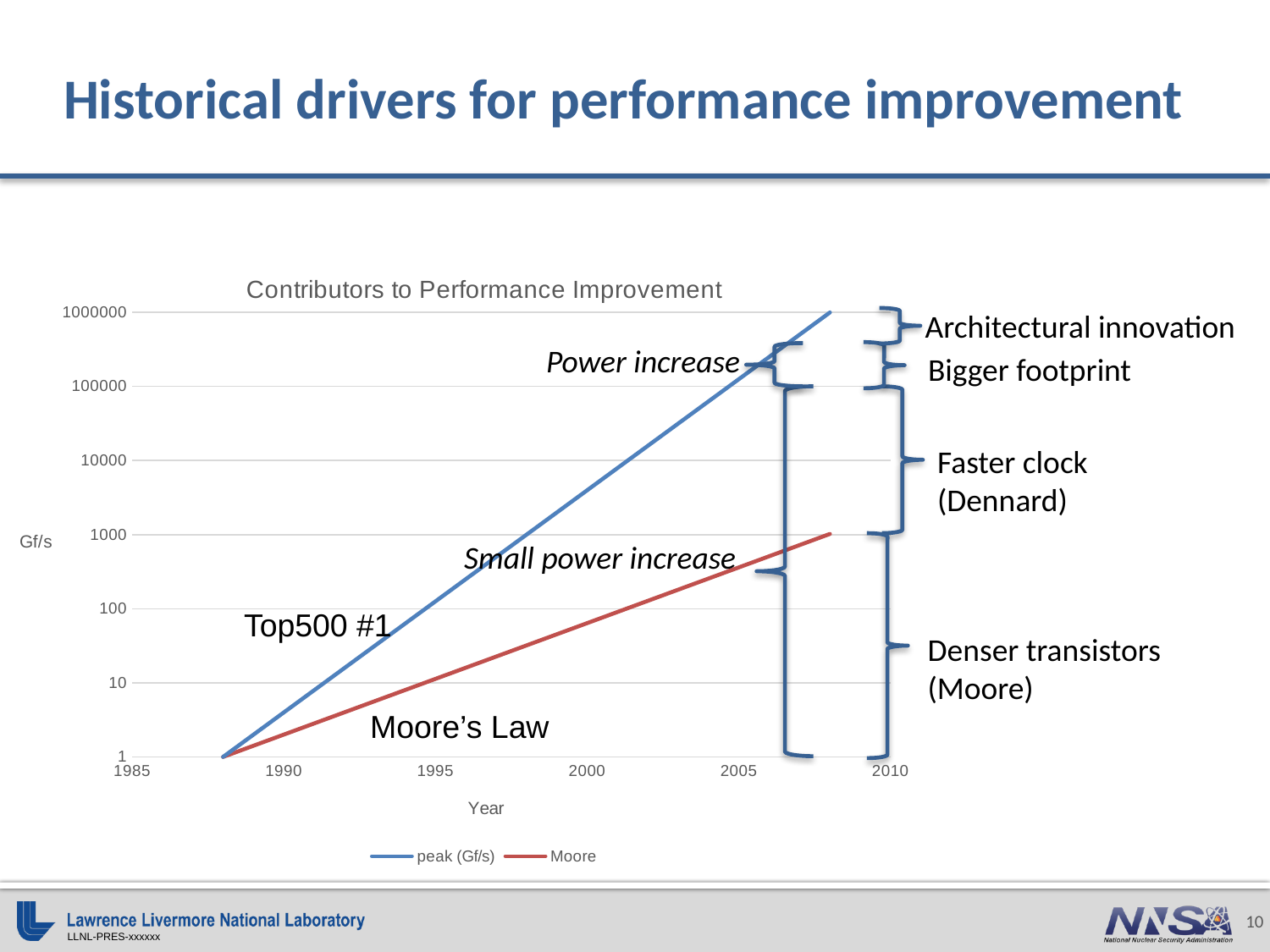
What is the title of the chart? Contributors to Performance Improvement At the year 1995, which series has the higher value, peak (Gf/s) or Moore? peak (Gf/s) Does the peak (Gf/s) series rise or fall as the year increases? rise Is the value of the Moore series at the year 2005 greater or less than 100? greater Does the Moore series rise or fall as the year increases? rise At the year 2005, which series has the higher value, peak (Gf/s) or Moore? peak (Gf/s) Is the value of the peak (Gf/s) series at the year 2005 greater or less than 10000? greater What kind of chart is shown on the slide? line chart Is the value of the Moore series at the year 2000 greater or less than 1000? less What are the two series named in the chart legend? peak (Gf/s) and Moore How many series does the legend of the chart list? 2